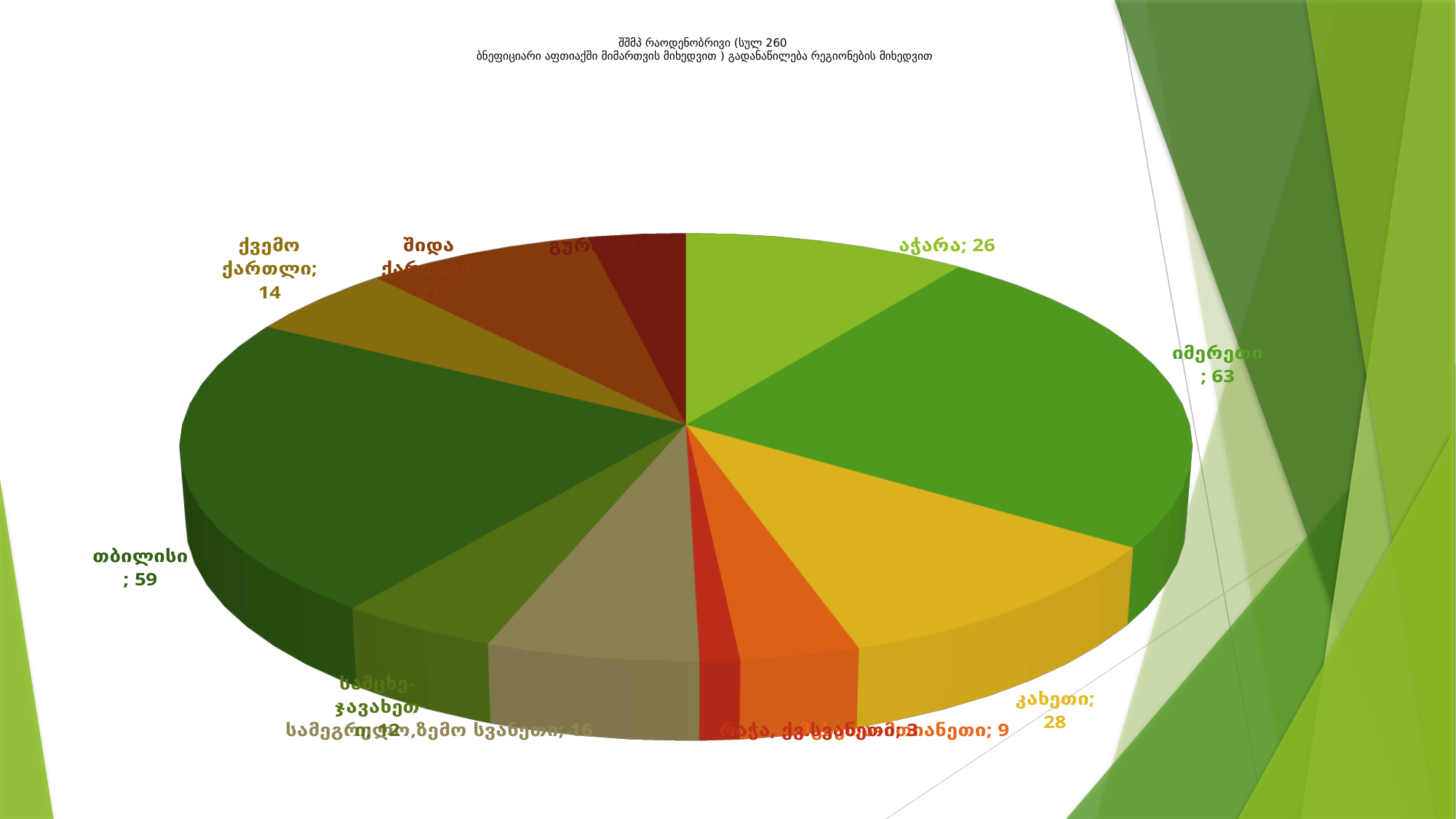
What is the value for ქვემო ქართლი in the pie chart? 14 Which region has the largest slice in the pie chart? იმერეთი What kind of chart is shown on the slide? Pie chart What is the difference between the values for იმერეთი and თბილისი? 4 What is the value for კახეთი in the pie chart? 28 What is the value for სამცხე-ჯავახეთი in the pie chart? 12 What is the difference between the values for კახეთი and აჭარა? 2 What is the value for თბილისი in the pie chart? 59 What is the value for აჭარა in the pie chart? 26 Which is larger, the value for თბილისი or the value for იმერეთი? იმერეთი What is the value for იმერეთი in the pie chart? 63 According to the chart title, what is the total number of beneficiaries? 260